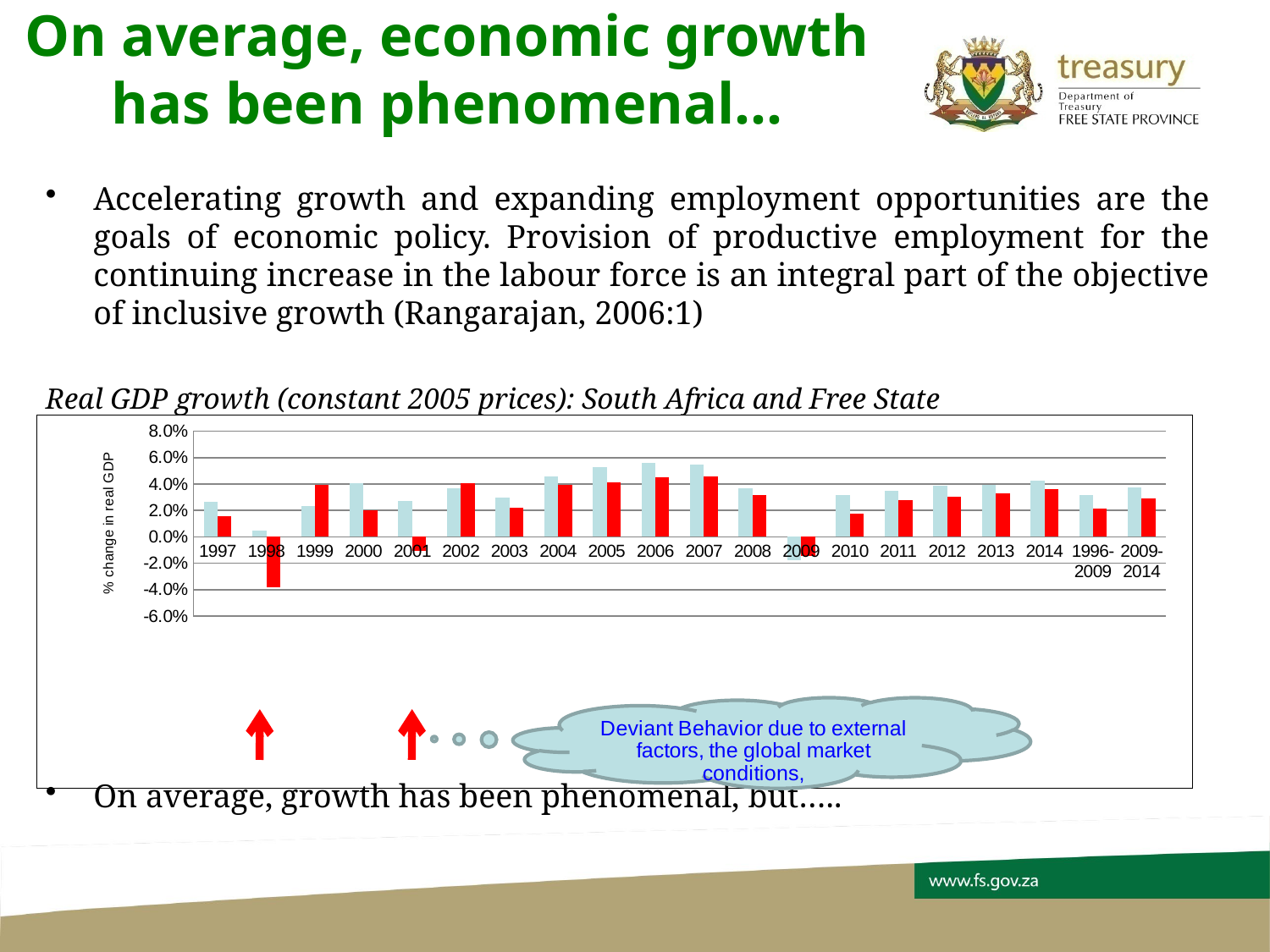
What is the title of the chart? Real GDP growth (constant 2005 prices): South Africa and Free State Is the value of the red bar for 1998 greater or less than -2.0%? less Do the red bars rise or fall from 2010 to 2014? rise How many categories are shown along the x axis of the chart? 20 Is the value of the red bar for 2009 greater or less than 0.0%? less Which category has the lowest value for the light blue bars? 2009 For 2001, which bar is larger, the light blue bar or the red bar? the light blue bar What kind of chart is shown on the slide? bar chart Is the value of the light blue bar for 2006 greater or less than 4.0%? greater Which category has the lowest value for the red bars? 1998 What is the label on the vertical axis of the chart? % change in real GDP